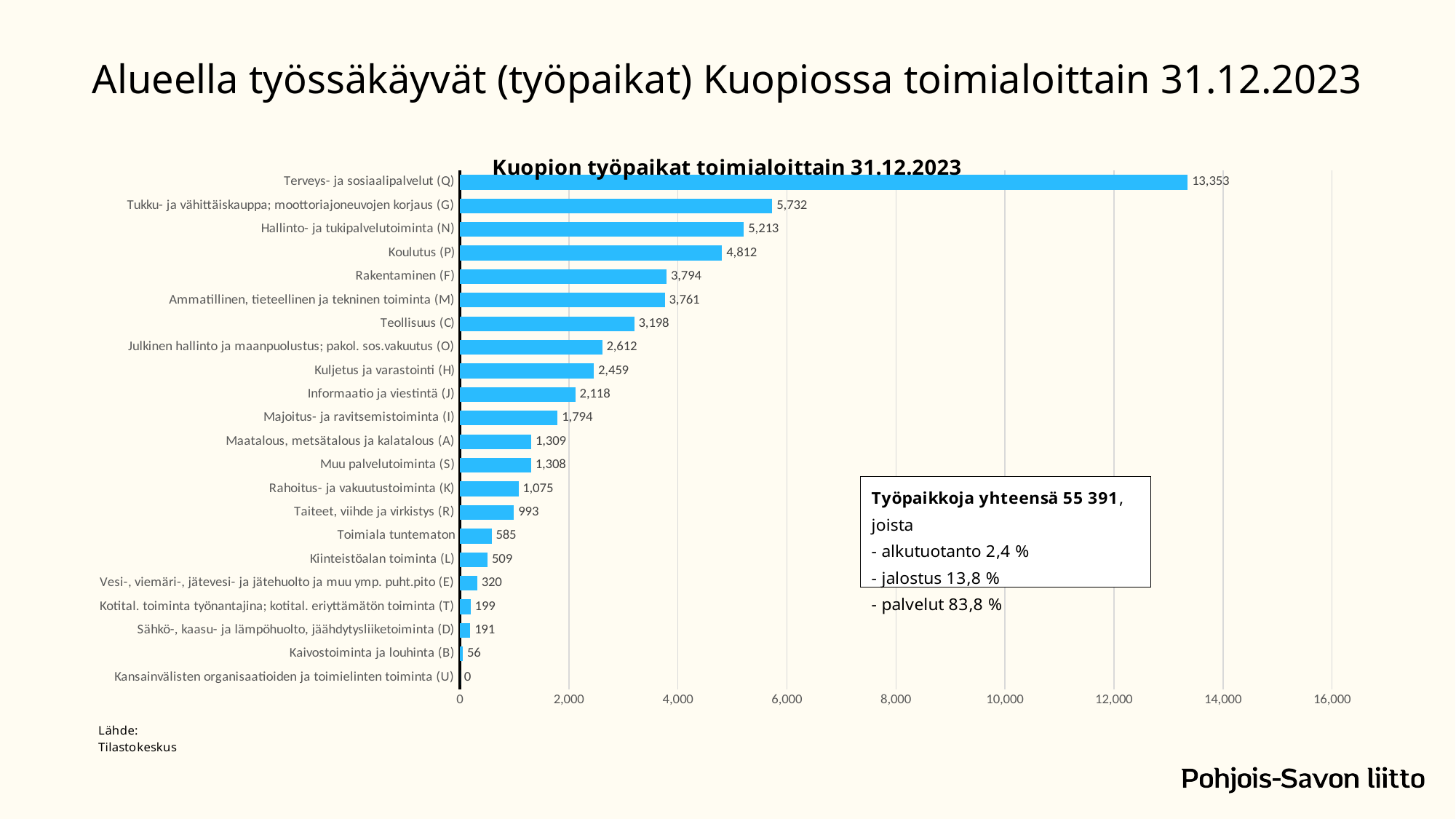
What is the value for Koulutus (P)? 4,812 What is the difference between Tukku- ja vähittäiskauppa; moottoriajoneuvojen korjaus (G) and Hallinto- ja tukipalvelutoiminta (N)? 519 Which category has the lowest value? Kansainvälisten organisaatioiden ja toimielinten toiminta (U) Which category has the highest value? Terveys- ja sosiaalipalvelut (Q) What is the difference between Maatalous, metsätalous ja kalatalous (A) and Muu palvelutoiminta (S)? 1 What is the value for Teollisuus (C)? 3,198 How many categories are shown in the chart? 22 What is the title of the chart? Kuopion työpaikat toimialoittain 31.12.2023 What kind of chart is shown? bar chart Which is larger, Kuljetus ja varastointi (H) or Informaatio ja viestintä (J)? Kuljetus ja varastointi (H) What is the value for Kaivostoiminta ja louhinta (B)? 56 Is the value for Terveys- ja sosiaalipalvelut (Q) greater or less than 12,000? greater